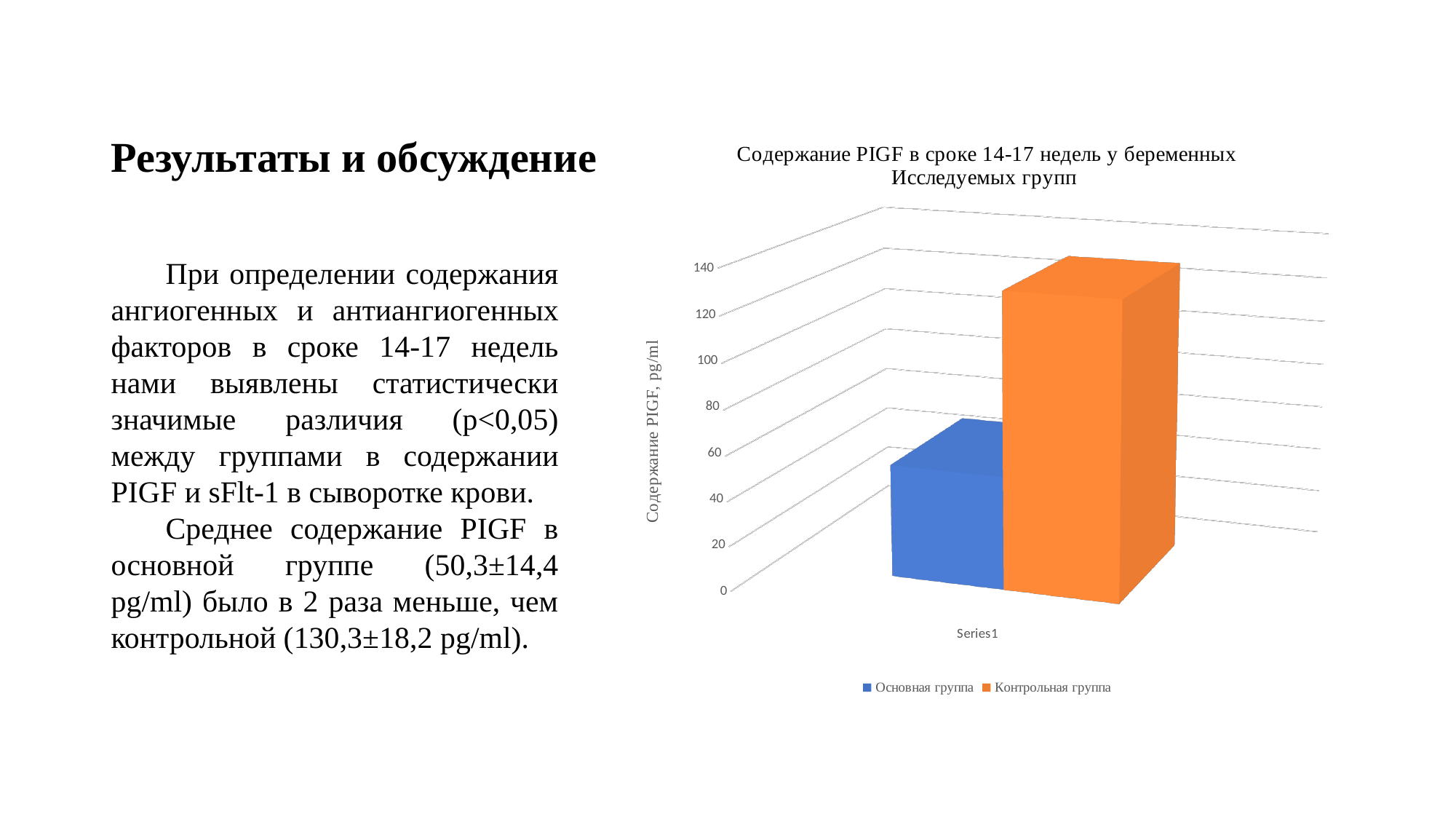
Is the value for Основная группа greater or less than 20? greater What are the two entries in the chart legend? Основная группа, Контрольная группа Which series has the taller bar, Основная группа or Контрольная группа? Контрольная группа Is the value for Контрольная группа greater or less than 80? greater What kind of chart is shown on the slide? bar chart What is the label of the vertical axis of the chart? Содержание PIGF, pg/ml Is the value for Основная группа greater or less than 100? less Which series has the lowest value in the chart? Основная группа How many categories are shown on the x axis of the chart? 1 How many series does the chart legend list? 2 Which series has the highest value in the chart? Контрольная группа